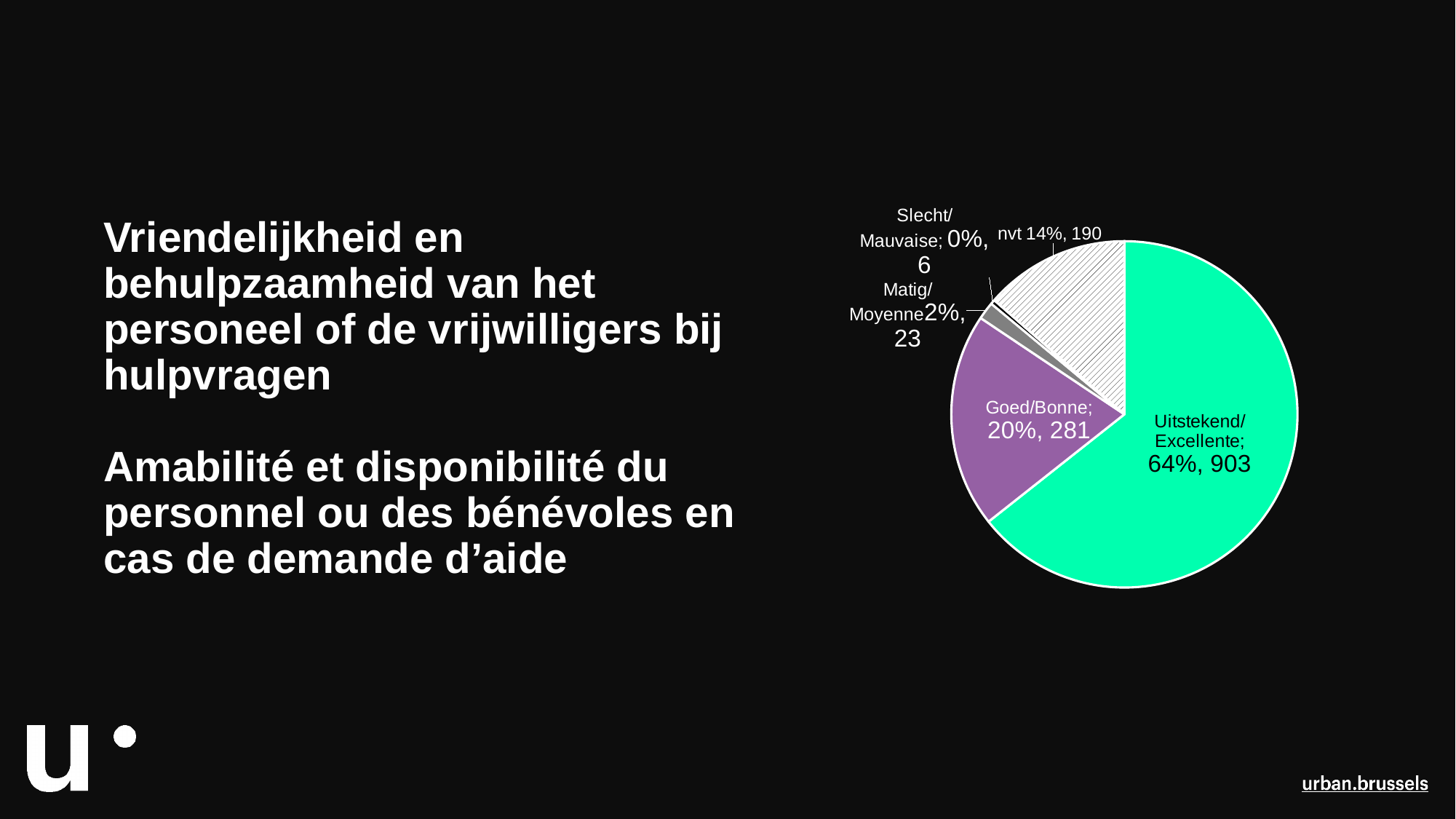
What colour is the Goed/Bonne slice? purple Which slice is the smallest? Slecht/Mauvaise What percentage share does the Goed/Bonne slice have? 20% What is the difference in count between Uitstekend/Excellente and Goed/Bonne? 622 What is the count for the Matig/Moyenne slice? 23 How many slices does the pie chart have? 5 Which has a larger count, nvt or Goed/Bonne? Goed/Bonne What is the count for the nvt slice? 190 What kind of chart is shown on the slide? pie chart What is the count for the Uitstekend/Excellente slice? 903 Which slice is the largest? Uitstekend/Excellente What percentage share does the Slecht/Mauvaise slice have? 0%